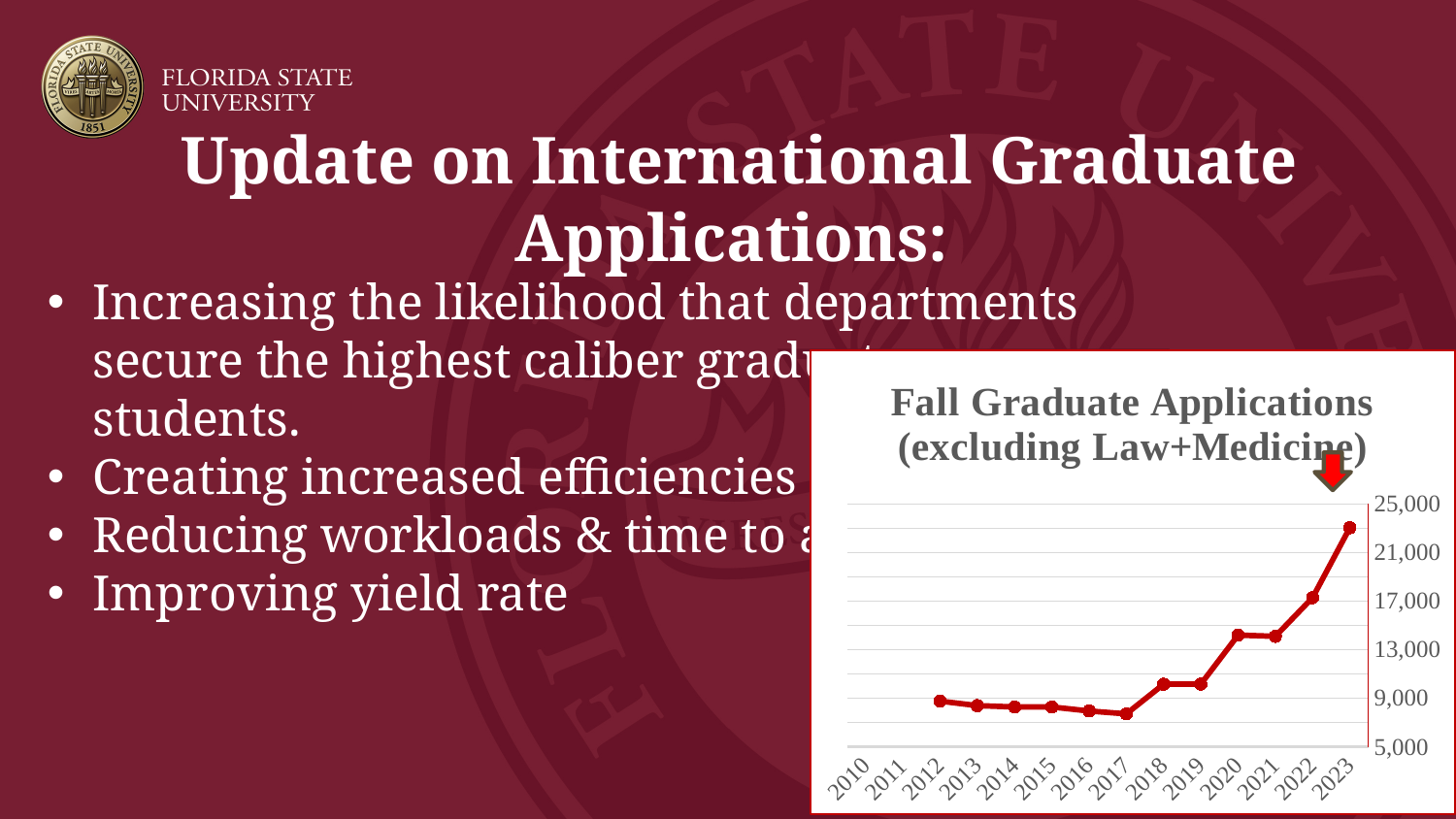
What is the title of the chart on the slide? Fall Graduate Applications (excluding Law+Medicine) What kind of chart is shown on the slide? line chart Do fall graduate applications overall rise or fall from 2017 to 2023? rise Which year has the larger value, 2020 or 2018? 2020 Which year has the highest number of fall graduate applications in the chart? 2023 What is the highest value shown on the y axis of the chart? 25,000 Is the value for 2018 greater or less than 9,000? greater Is the value for 2017 greater or less than 9,000? less Is the value for 2023 greater or less than 21,000? greater How many years are labelled on the x axis of the chart? 14